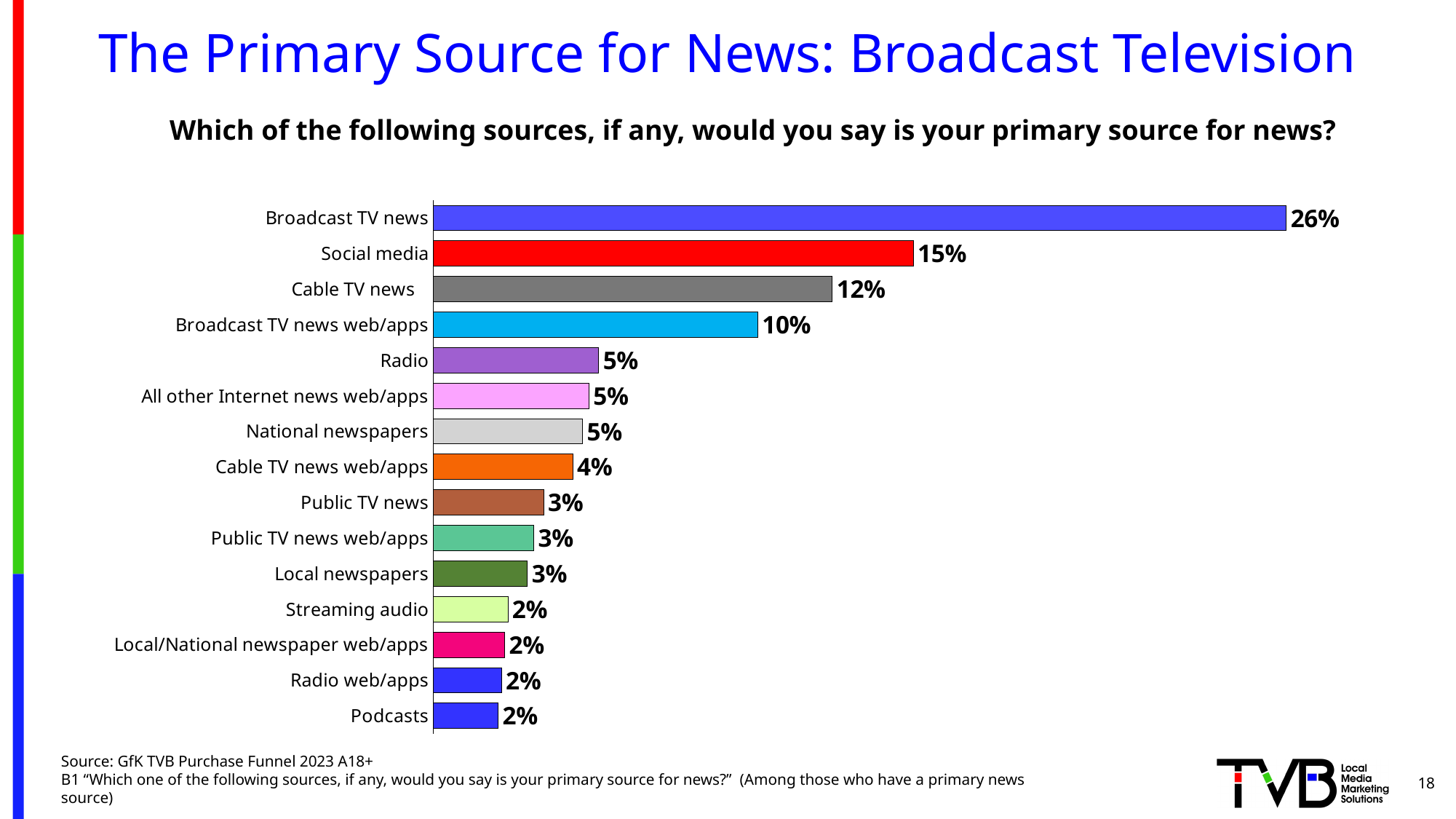
Which source has the highest percentage in the chart? Broadcast TV news What percentage is shown for Cable TV news web/apps? 4% What is the value shown for Social media? 15% What survey question is shown above the chart? Which of the following sources, if any, would you say is your primary source for news? What percentage of respondents named Broadcast TV news as their primary source for news? 26% What is the difference in percentage points between Broadcast TV news and Social media? 11 What is the difference between Cable TV news and Broadcast TV news web/apps? 2% What is the value shown for Streaming audio? 2% How many news sources are listed in the chart? 15 Which has a larger value, Public TV news or Broadcast TV news web/apps? Broadcast TV news web/apps What kind of chart is shown on the slide? Bar chart Which has a larger value, Cable TV news or Radio? Cable TV news